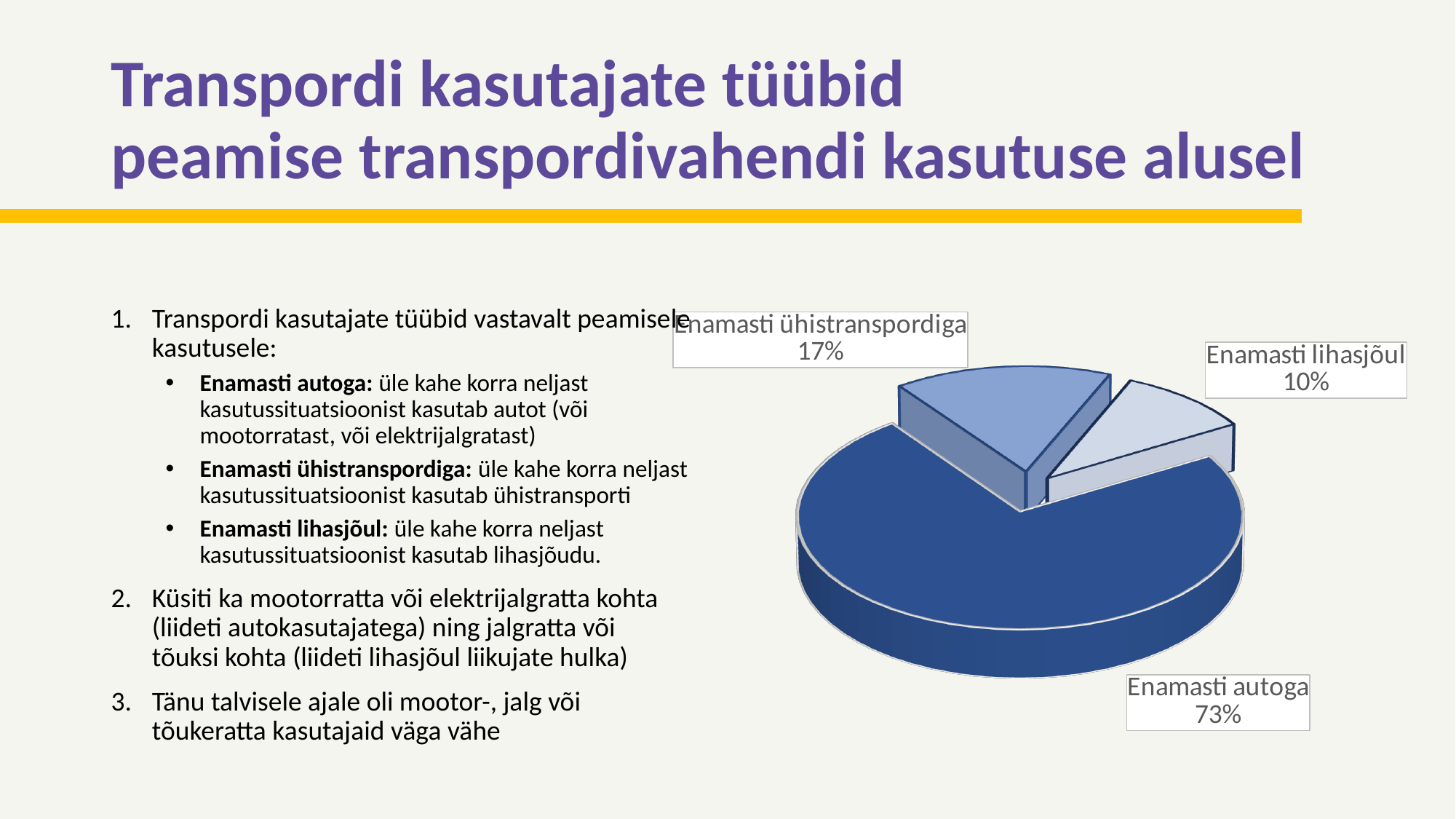
What share of the pie does 'Enamasti ühistranspordiga' represent? 17% Which slice of the pie is shown in the darkest blue? Enamasti autoga Which category has the largest slice of the pie? Enamasti autoga What share of the pie does 'Enamasti autoga' represent? 73% What is the combined share of 'Enamasti ühistranspordiga' and 'Enamasti lihasjõul'? 27% Which category has the smallest slice of the pie? Enamasti lihasjõul What share of the pie does 'Enamasti lihasjõul' represent? 10% What is the difference in percentage points between 'Enamasti autoga' and 'Enamasti ühistranspordiga'? 56 Which is larger, the slice for 'Enamasti ühistranspordiga' or the slice for 'Enamasti lihasjõul'? Enamasti ühistranspordiga What kind of chart is shown on the slide? Pie chart How many slices does the pie chart have? 3 What is the difference in percentage points between 'Enamasti ühistranspordiga' and 'Enamasti lihasjõul'? 7